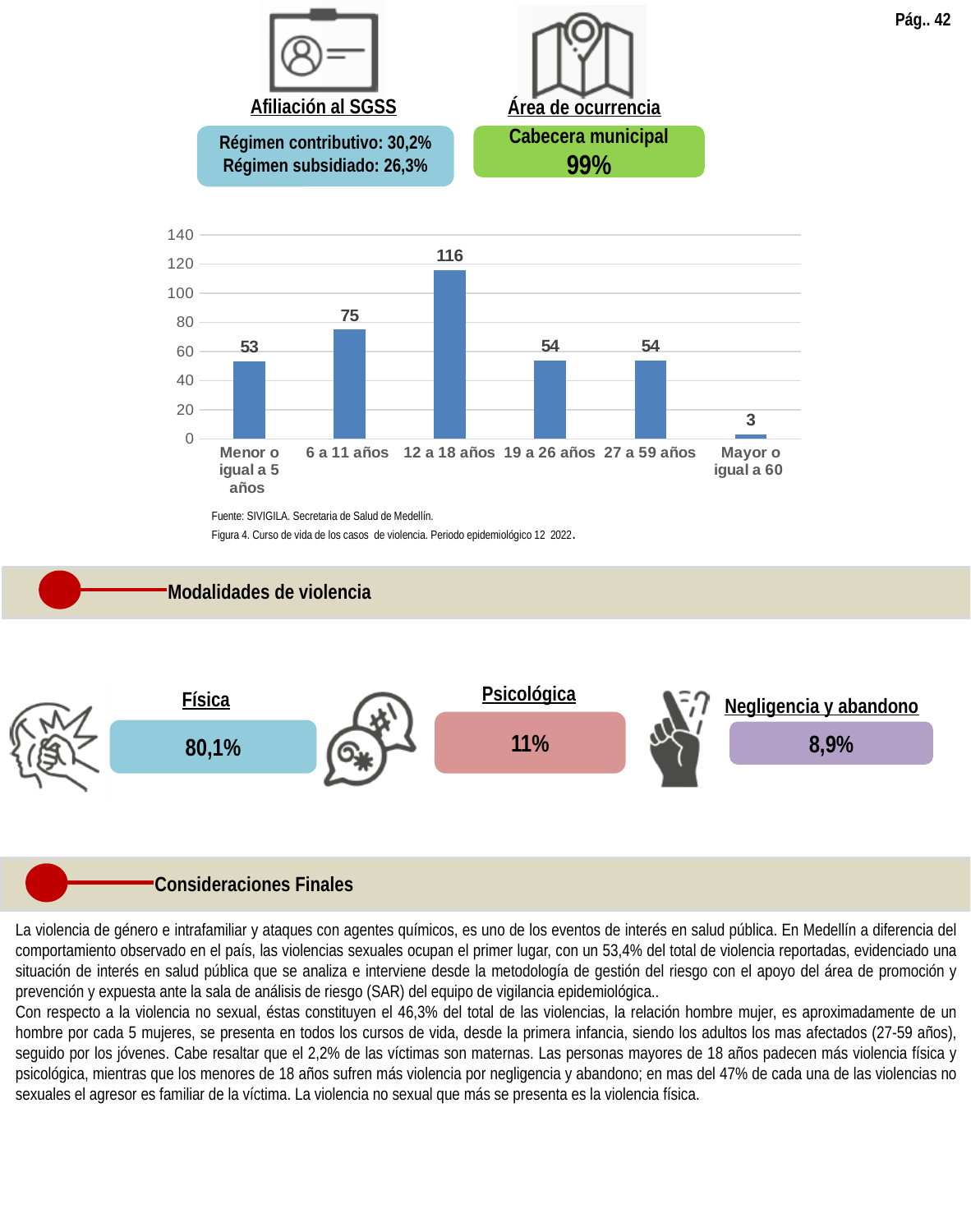
How many age-group categories are shown in the bar chart? 6 Which age group has the lowest value in the bar chart? Mayor o igual a 60 In the bar chart, what is the value for the category '6 a 11 años'? 75 In the bar chart, what is the difference between the values for '12 a 18 años' and '6 a 11 años'? 41 In the bar chart, what is the value for the category 'Menor o igual a 5 años'? 53 In the bar chart, is the value for '12 a 18 años' greater or less than 100? greater In the bar chart, which is larger: the value for '6 a 11 años' or the value for '19 a 26 años'? 6 a 11 años In the bar chart, what is the value for the category '12 a 18 años'? 116 According to the caption, what is the source of the data in the bar chart? SIVIGILA. Secretaria de Salud de Medellín. In the bar chart, what is the value for the category 'Mayor o igual a 60'? 3 What type of chart is shown in Figura 4 (Curso de vida de los casos de violencia)? bar chart Which age group has the highest value in the bar chart? 12 a 18 años